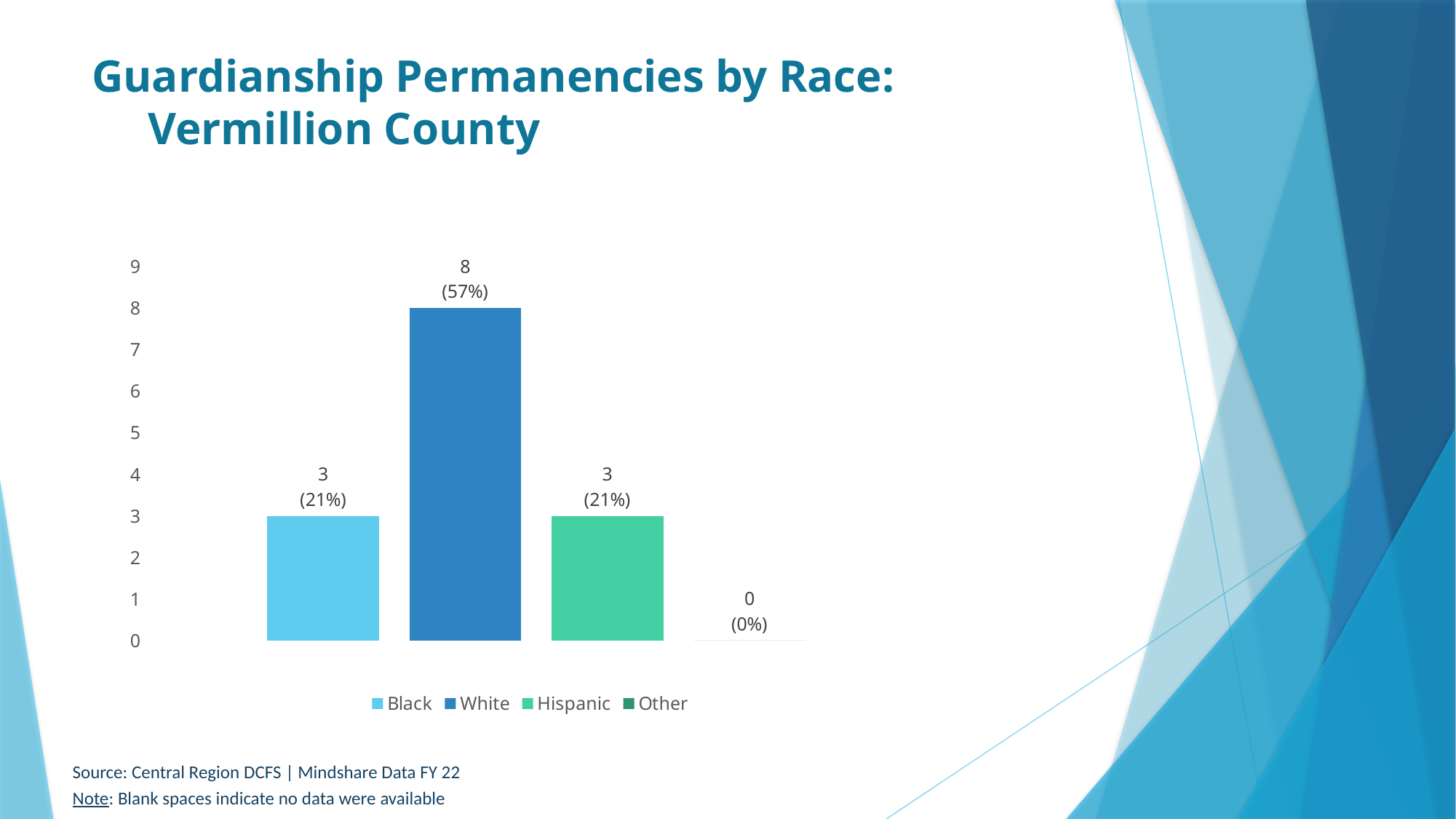
Which race has the lowest number of guardianship permanencies? Other What value is shown for Other? 0 Is the value for White greater or less than 5? greater What percentage is shown for White? 57% What percentage is shown for Black? 21% How many race categories does the legend list? 4 Which race has the highest number of guardianship permanencies? White What is the title of the chart on the slide? Guardianship Permanencies by Race: Vermillion County What is the difference between the values for White and Hispanic? 5 How many guardianship permanencies are shown for White? 8 What kind of chart is shown on the slide? Bar chart Which is larger, the value for White or the value for Black? White